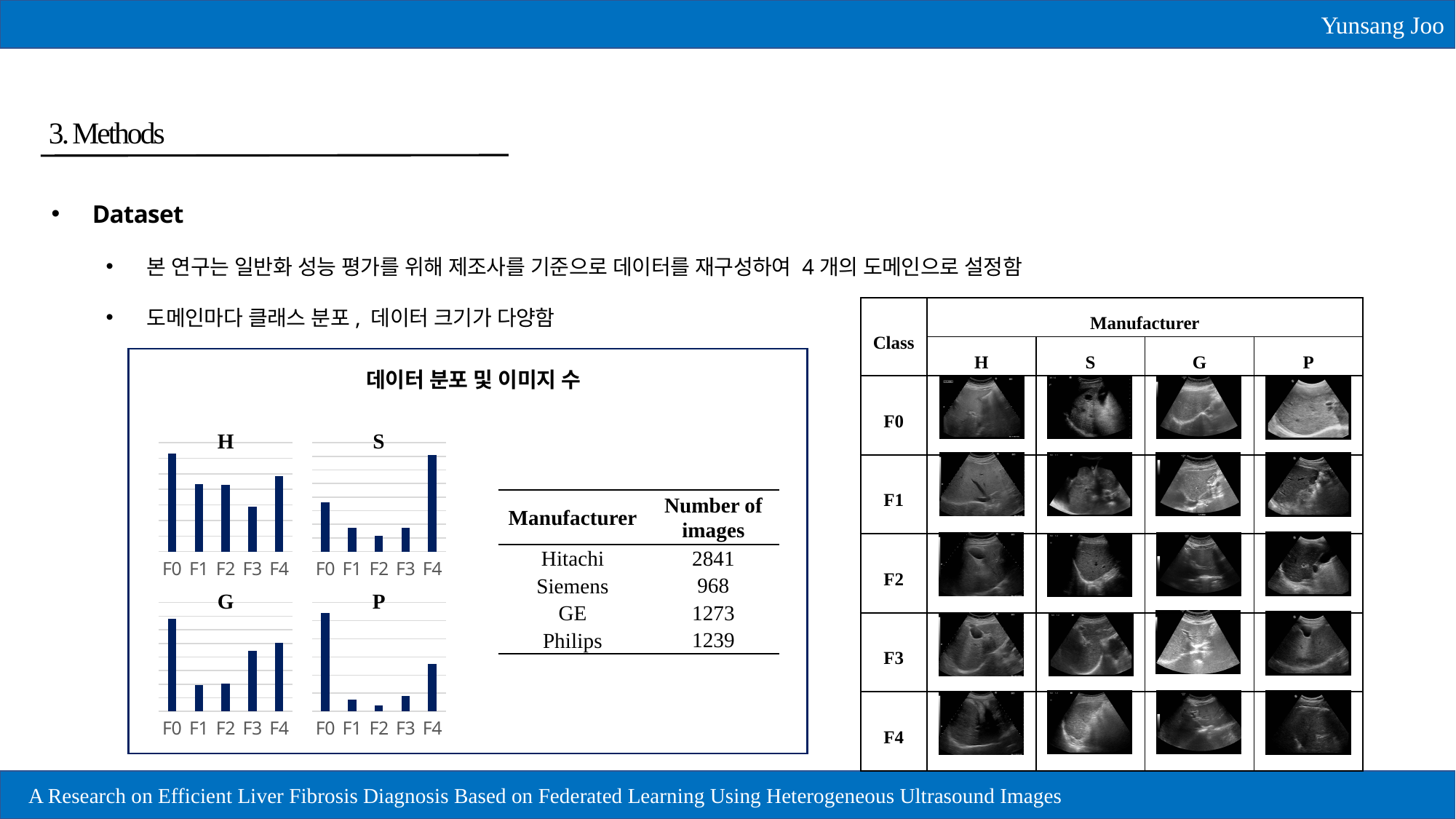
In the chart labelled P, which class has the lowest bar? F2 In the chart labelled H, which class has the highest bar? F0 In the chart labelled G, which is larger, the bar for F3 or the bar for F1? F3 In the chart labelled S, which class has the highest bar? F4 In the chart labelled P, which class has the highest bar? F0 In the chart labelled H, which is larger, the bar for F0 or the bar for F4? F0 How many classes are shown on the x axis of the chart labelled S? 5 In the chart labelled H, which class has the lowest bar? F3 What kind of chart is used for the four manufacturer panels (H, S, G, P)? Bar chart In the chart labelled S, which class has the lowest bar? F2 How many small bar charts are shown inside the box titled 데이터 분포 및 이미지 수? 4